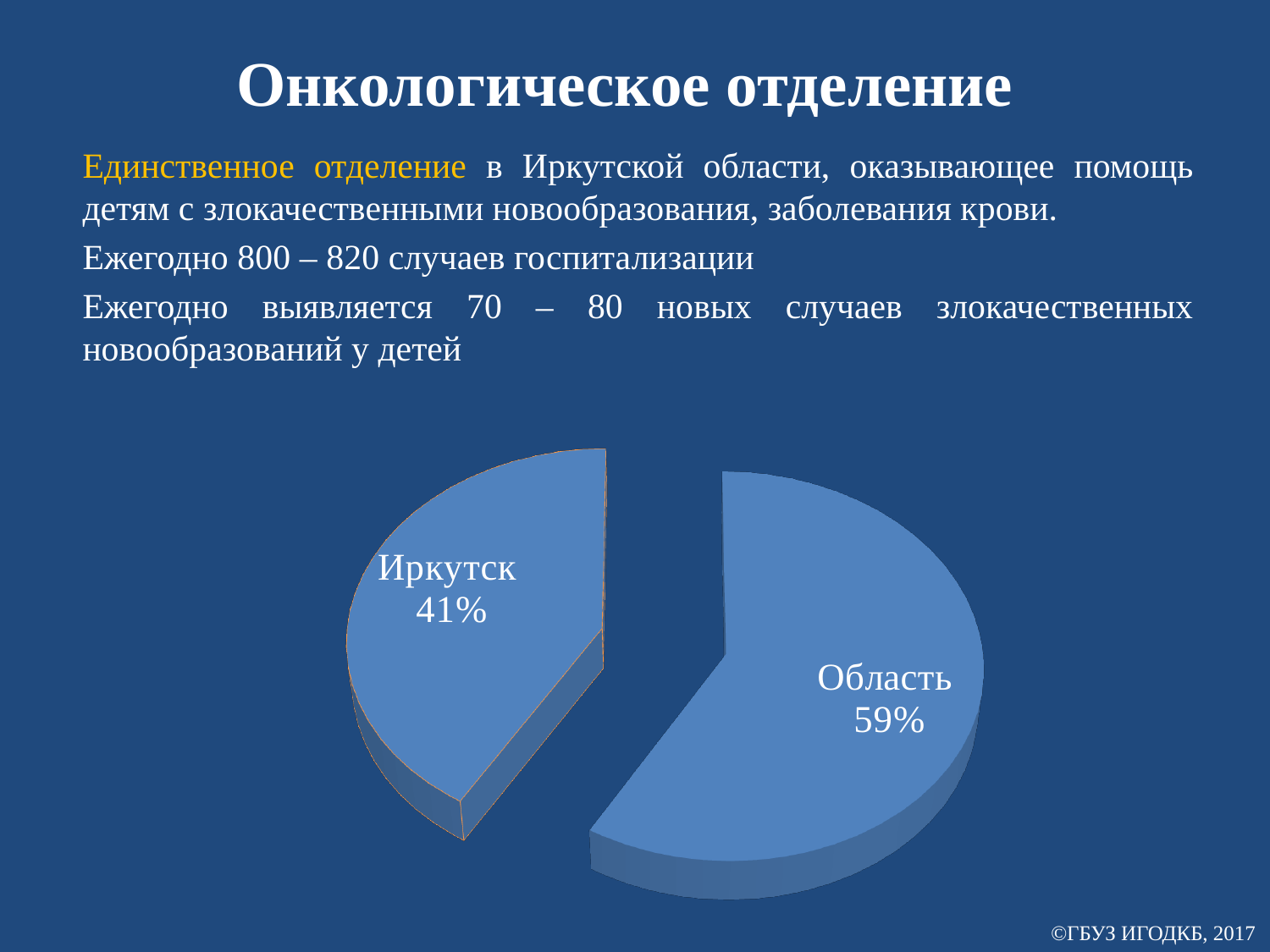
What is the difference in percentage points between the Область and Иркутск slices? 18 Is the share for Область greater or less than 50%? greater Which is larger, the Иркутск slice or the Область slice? Область What share of the pie does Область have? 59% Is the share for Иркутск greater or less than 50%? less Which slice of the pie is the largest? Область Which slice of the pie is the smallest? Иркутск What is the total of the two slice percentages shown on the pie chart? 100% What is the title of the slide containing the pie chart? Онкологическое отделение What kind of chart is shown on the slide? pie chart How many slices does the pie chart have? 2 What share of the pie does Иркутск have? 41%